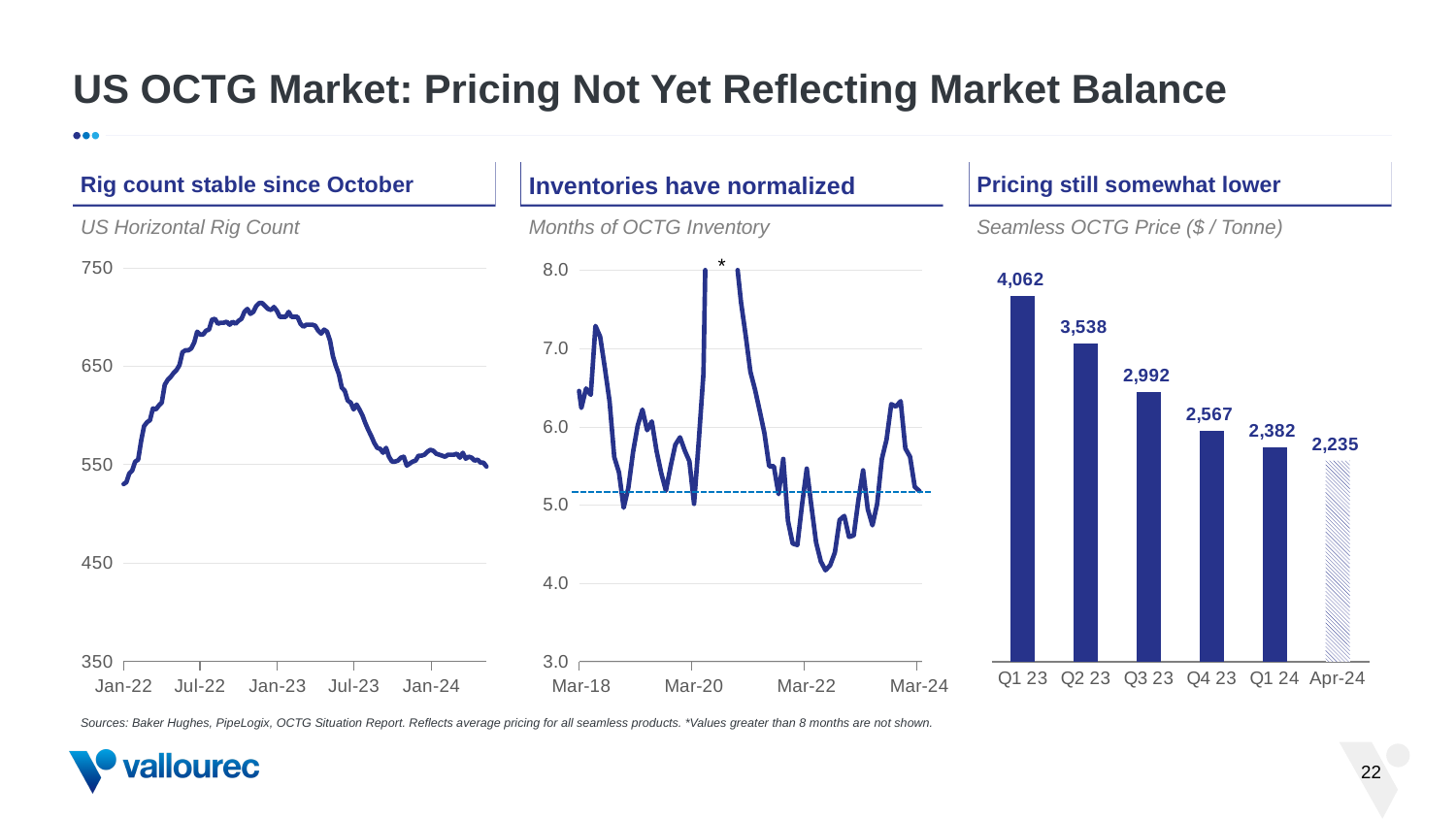
In the Seamless OCTG Price ($ / Tonne) chart, how many periods are shown? 6 What kind of chart is the Seamless OCTG Price ($ / Tonne) chart? bar chart In the Seamless OCTG Price ($ / Tonne) chart, what is the value for Q1 23? 4,062 In the Seamless OCTG Price ($ / Tonne) chart, what is the value for Q3 23? 2,992 What kind of chart is the US Horizontal Rig Count chart? line chart In the Seamless OCTG Price ($ / Tonne) chart, what is the difference between Q4 23 and Q1 24? 185 In the Seamless OCTG Price ($ / Tonne) chart, which period has the highest value? Q1 23 In the Seamless OCTG Price ($ / Tonne) chart, what is the difference between Q1 23 and Q2 23? 524 In the Seamless OCTG Price ($ / Tonne) chart, which period has the lowest value? Apr-24 In the Seamless OCTG Price ($ / Tonne) chart, what is the value for Apr-24? 2,235 In the US Horizontal Rig Count chart, is the value at Jan-24 greater or less than 650? less In the Seamless OCTG Price ($ / Tonne) chart, do values rise or fall from Q1 23 to Apr-24? fall